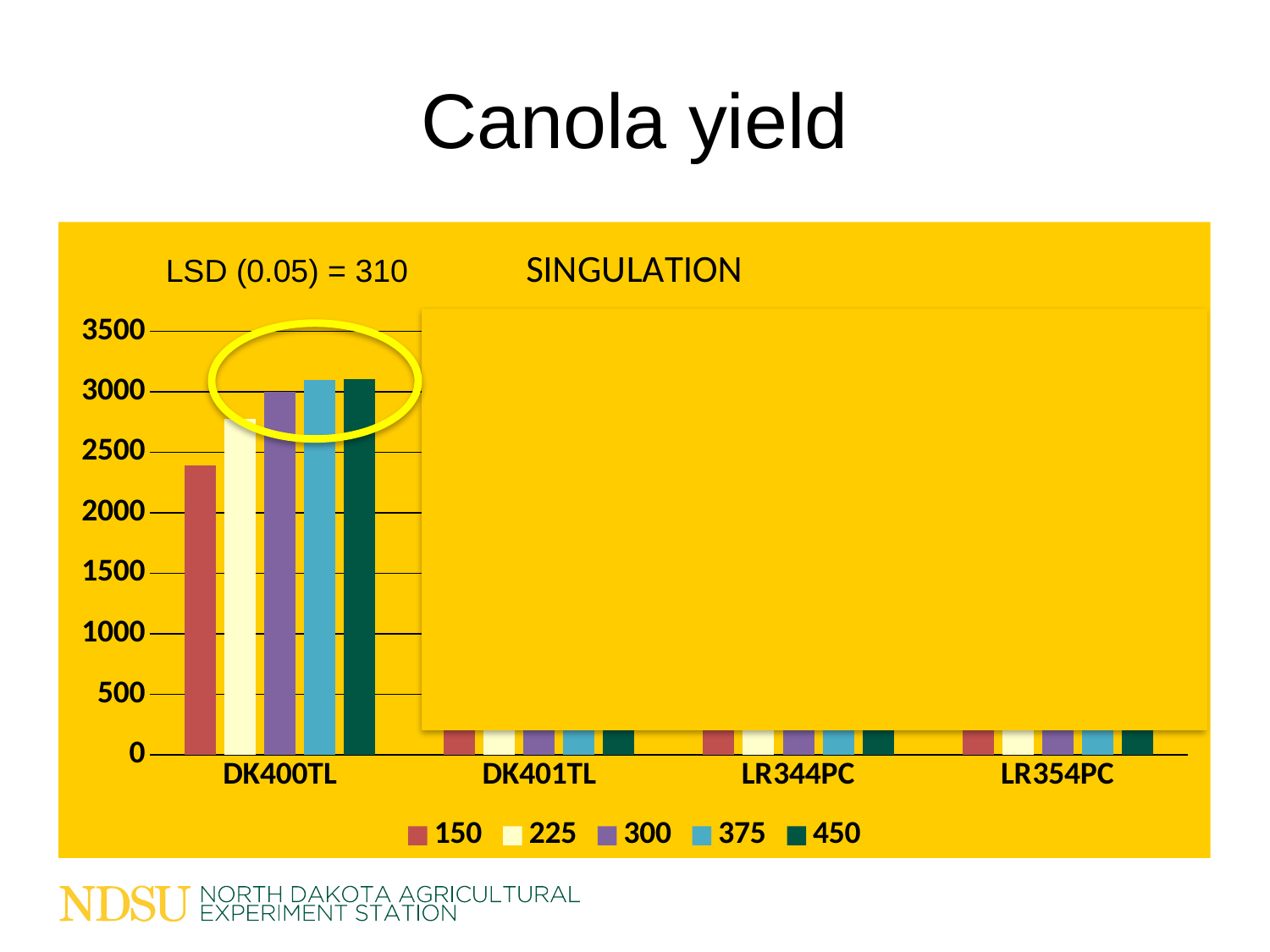
Which series has the lowest value for DK400TL? 150 What is the title of the slide containing the chart? Canola yield For DK400TL, do the values rise or fall going from the 150 series to the 375 series? rise How many categories are shown on the x axis of the chart? 4 How many series does the chart legend list? 5 What LSD value is printed on the chart? LSD (0.05) = 310 Is the value for the 375 series at DK400TL greater or less than 2500? greater For DK400TL, which is larger: the value for the 150 series or the 300 series? 300 Is the value for the 150 series at DK400TL greater or less than 2500? less Is the value for the 150 series at DK400TL greater or less than 2000? greater What kind of chart is shown on the slide? bar chart